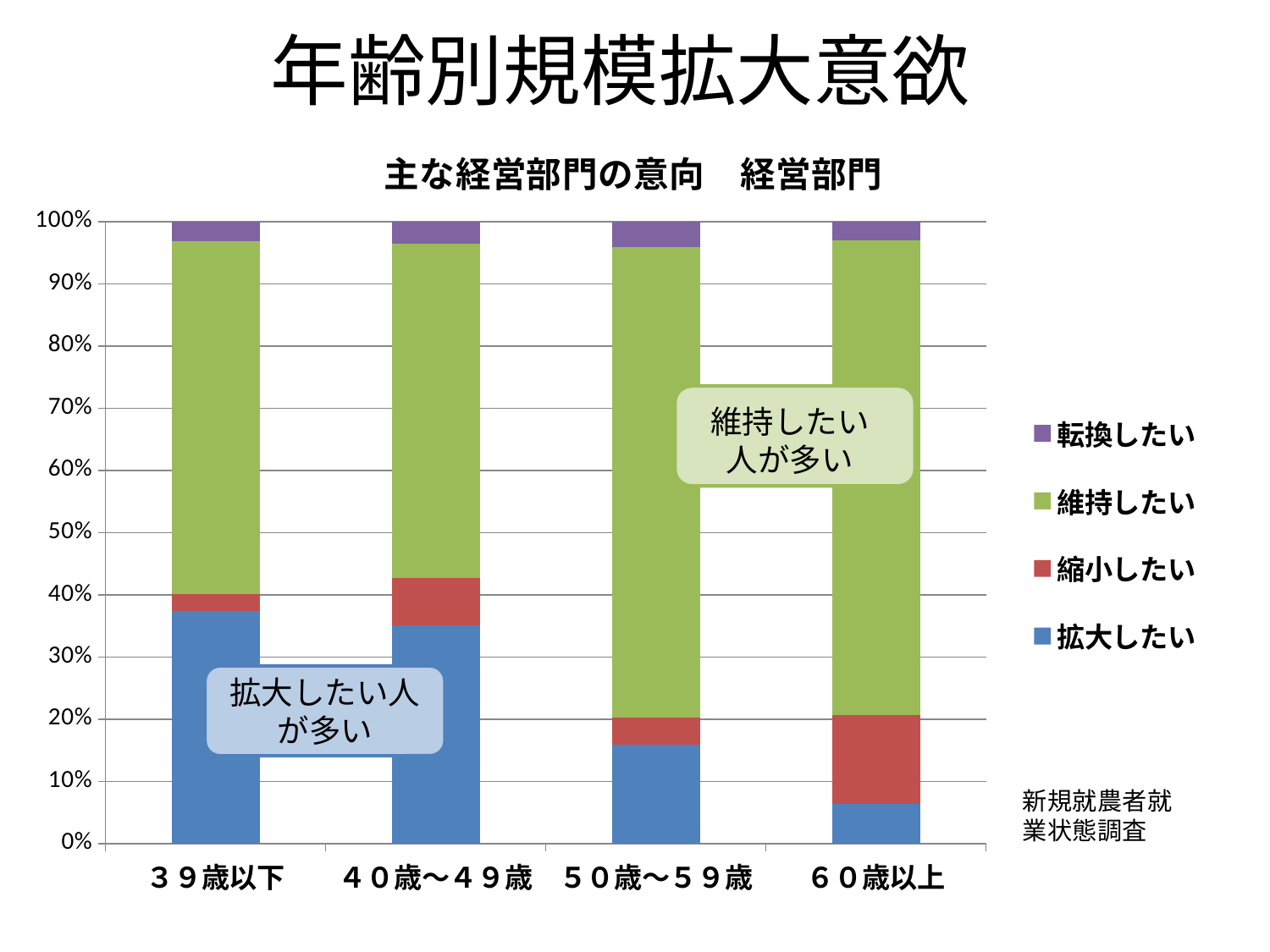
Which legend entry is shown in blue? 拡大したい Which age category has the smallest 拡大したい share? 60歳以上 What is the title of the chart? 主な経営部門の意向 経営部門 Which age category has the largest 縮小したい share? 60歳以上 How many age categories are shown on the x axis? 4 Does the 拡大したい share rise or fall as the age categories move from left to right? fall Which is larger, the 拡大したい share for 40歳〜49歳 or for 50歳〜59歳? 40歳〜49歳 Is the value for 拡大したい in the 39歳以下 bar greater or less than 30%? greater Is the value for 拡大したい in the 60歳以上 bar greater or less than 10%? less What kind of chart is shown on the slide? Stacked bar chart How many series does the legend list? 4 Is the value for 拡大したい in the 50歳〜59歳 bar greater or less than 20%? less